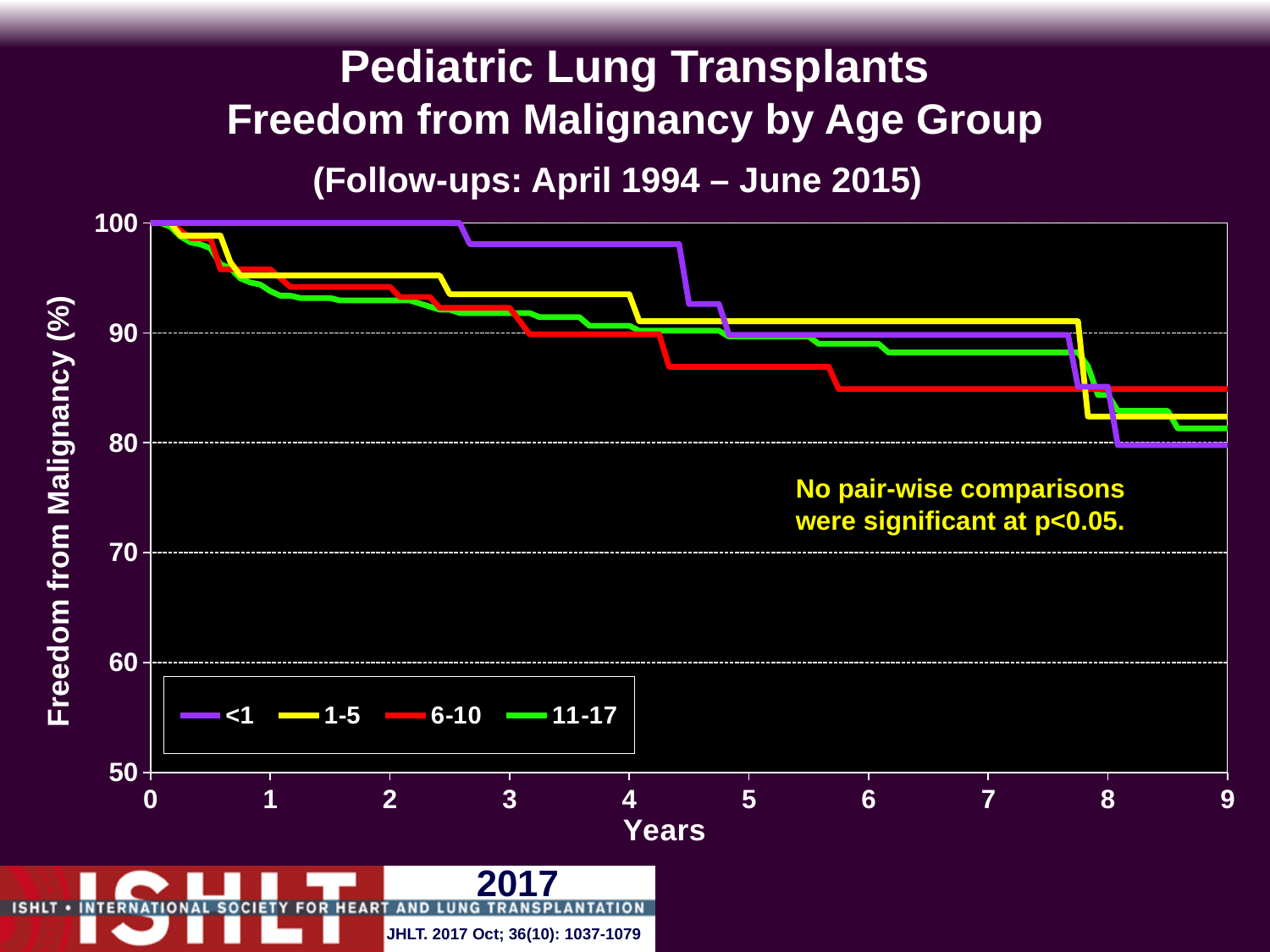
What is the freedom from malignancy value for all age groups at year 0? 100 Is the value for the <1 age group at year 2 greater or less than 90? greater Which age group has the lowest freedom from malignancy at year 6? 6-10 Is the value for the 6-10 age group at year 5 greater or less than 80? greater What does the annotation on the chart say about pair-wise comparisons? No pair-wise comparisons were significant at p<0.05. Do the freedom from malignancy curves rise or fall as years increase? fall Is the value for the 6-10 age group at year 6 greater or less than 90? less What kind of chart is shown on the slide? line chart Which age group has the highest freedom from malignancy at year 2? <1 At year 6, which is higher: the 1-5 age group or the 6-10 age group? 1-5 How many age groups does the legend list? 4 Which age groups are listed in the legend? <1, 1-5, 6-10, 11-17